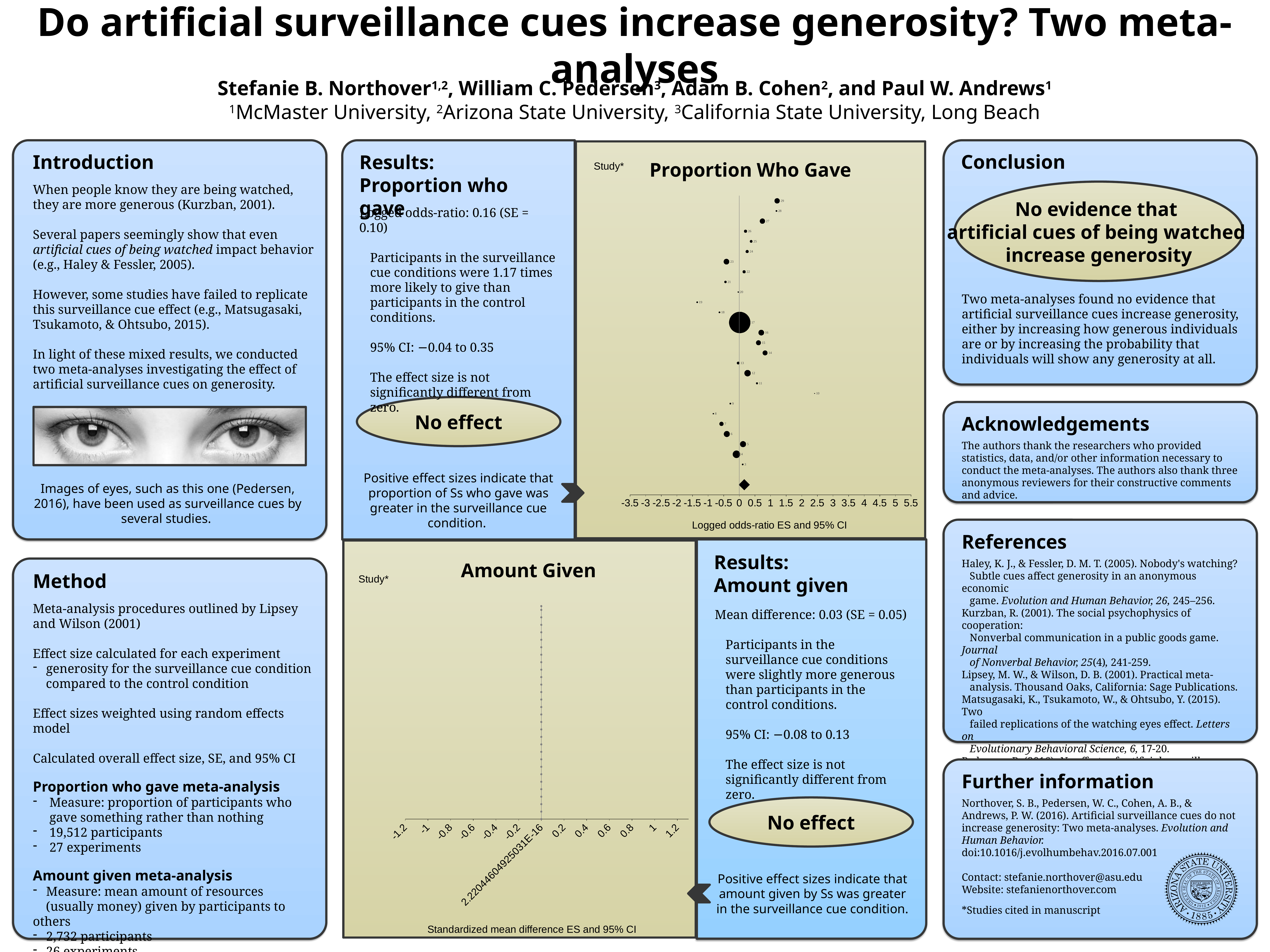
On the Proportion Who Gave chart, is the value for study 3 greater or less than 0? less On the Proportion Who Gave chart, which study has the smallest (leftmost) effect size? study 19 On the Proportion Who Gave chart, is the value for study 19 greater or less than 0? less On the Proportion Who Gave chart, which has the larger effect size, study 10 or study 19? study 10 On the Amount Given chart, what is the x-axis label? Standardized mean difference ES and 95% CI On the Proportion Who Gave chart, is the value for study 23 greater or less than 0? less What kind of chart is the Proportion Who Gave chart? scatter chart On the Proportion Who Gave chart, which study has the largest (rightmost) effect size? study 10 On the Proportion Who Gave chart, what is the x-axis label? Logged odds-ratio ES and 95% CI